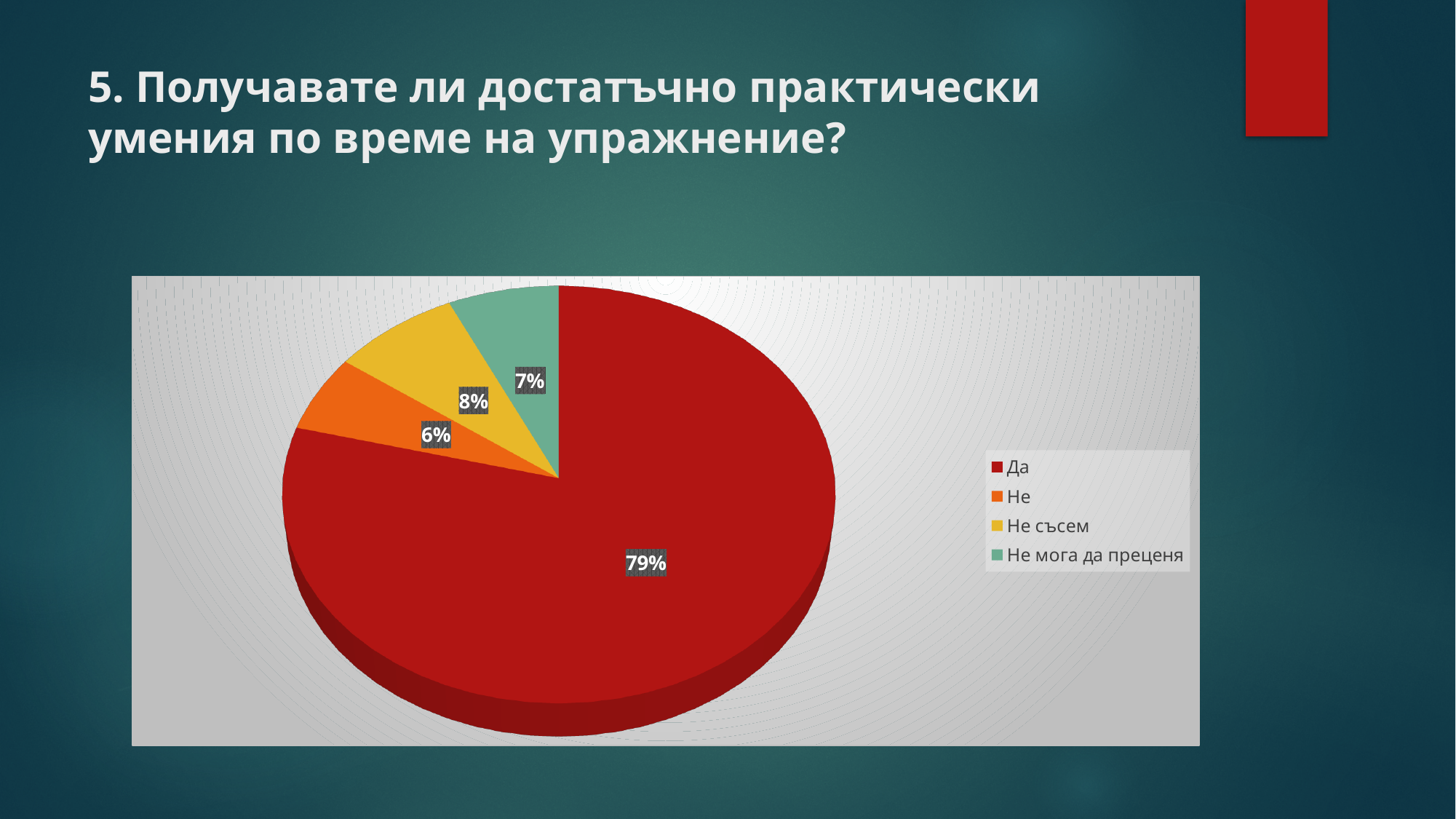
Which category has the smallest slice of the pie? Не What colour is the slice for "Не мога да преценя"? green What share of the pie does "Не съсем" have? 8% How many categories does the pie chart have? 4 What share of the pie does "Не" have? 6% Which category has the largest slice of the pie? Да What share of the pie does "Да" have? 79% What share of the pie does "Не мога да преценя" have? 7% What is the difference between the shares for "Да" and "Не съсем"? 71% What is the difference between the shares for "Не мога да преценя" and "Не"? 1% What kind of chart is shown on the slide? pie chart Which is larger, the share for "Не съсем" or the share for "Не"? Не съсем